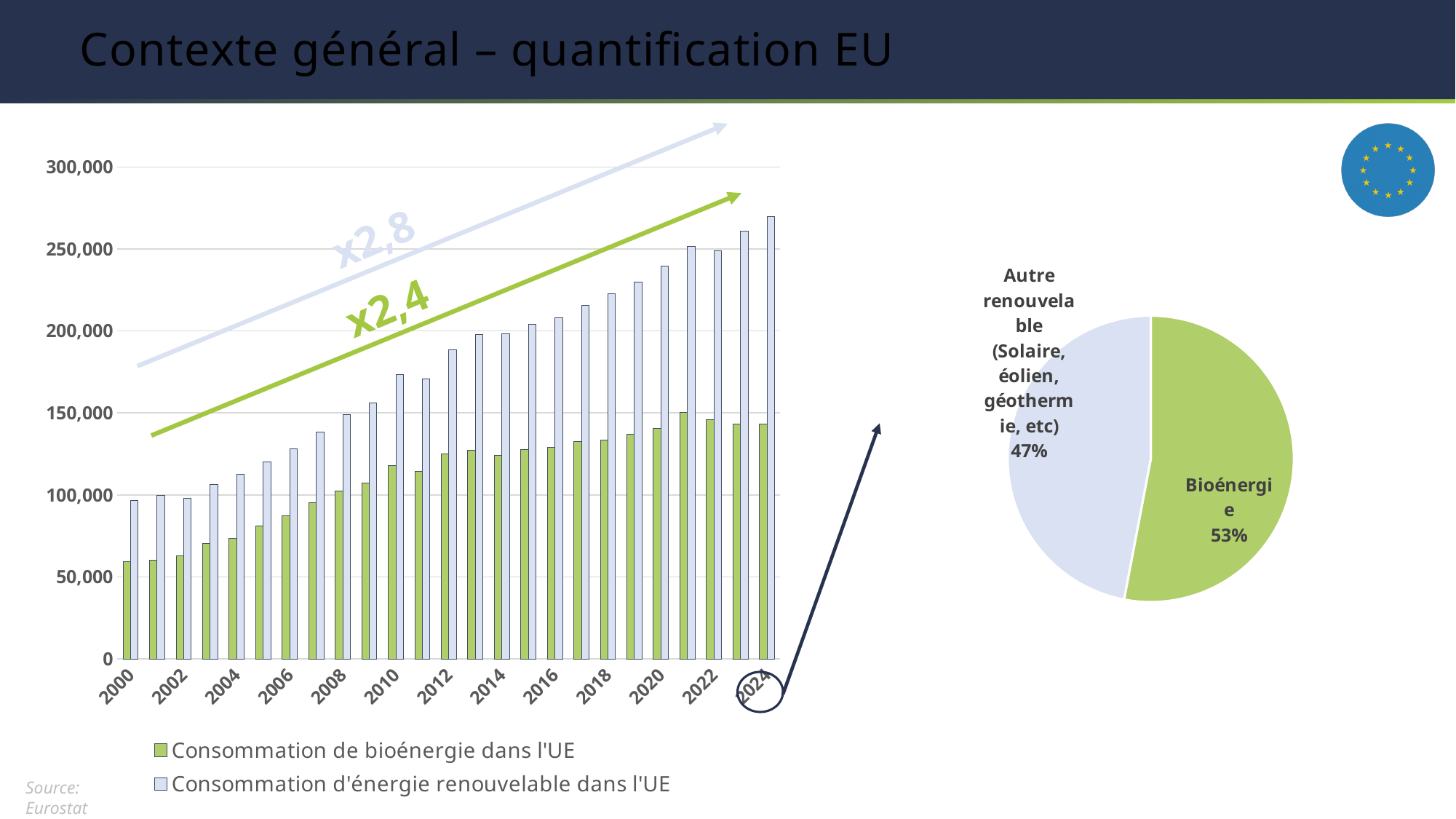
How many series does the legend of the bar chart on the left list? 2 In the pie chart on the right, which slice is the largest? Bioénergie In the bar chart on the left, does Consommation d'énergie renouvelable dans l'UE rise or fall from 2000 to 2024? rise What kind of chart is the chart on the right of the slide? pie chart In the bar chart on the left, which series has the larger value in 2024: Consommation de bioénergie dans l'UE or Consommation d'énergie renouvelable dans l'UE? Consommation d'énergie renouvelable dans l'UE In the bar chart on the left, is the value for Consommation d'énergie renouvelable dans l'UE in 2010 greater or less than 150,000? greater In the bar chart on the left, is the value for Consommation d'énergie renouvelable dans l'UE in 2024 greater or less than 250,000? greater In the bar chart on the left, is the value for Consommation de bioénergie dans l'UE in 2020 greater or less than 100,000? greater In the pie chart on the right, what share does Bioénergie have? 53% What kind of chart is the chart on the left of the slide? bar chart In the pie chart on the right, what is the difference between the Bioénergie share and the Autre renouvelable share? 6%